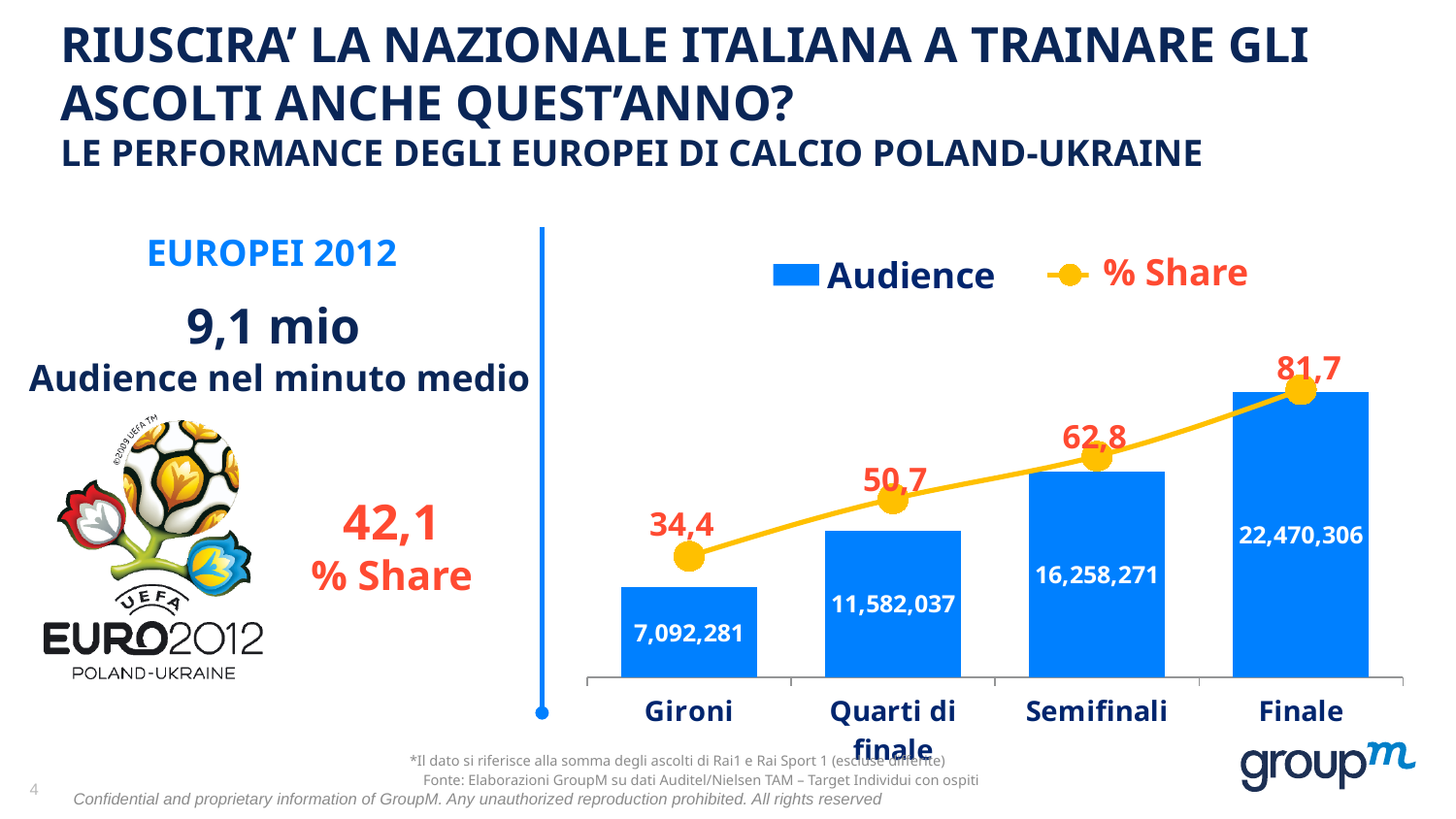
How many series does the chart legend list? 2 What is the Audience value for Gironi? 7,092,281 Which category has the highest Audience? Finale What is the % Share value for Semifinali? 62,8 What is the difference in Audience between Finale and Semifinali? 6,212,035 How many categories are shown on the x axis of the chart? 4 Which category has the lowest % Share? Gironi What is the % Share value for Quarti di finale? 50,7 What is the Audience value for Finale? 22,470,306 What is the difference in % Share between Finale and Gironi? 47,3 Which has a larger Audience, Quarti di finale or Semifinali? Semifinali Does the % Share rise or fall from Gironi to Finale? rise